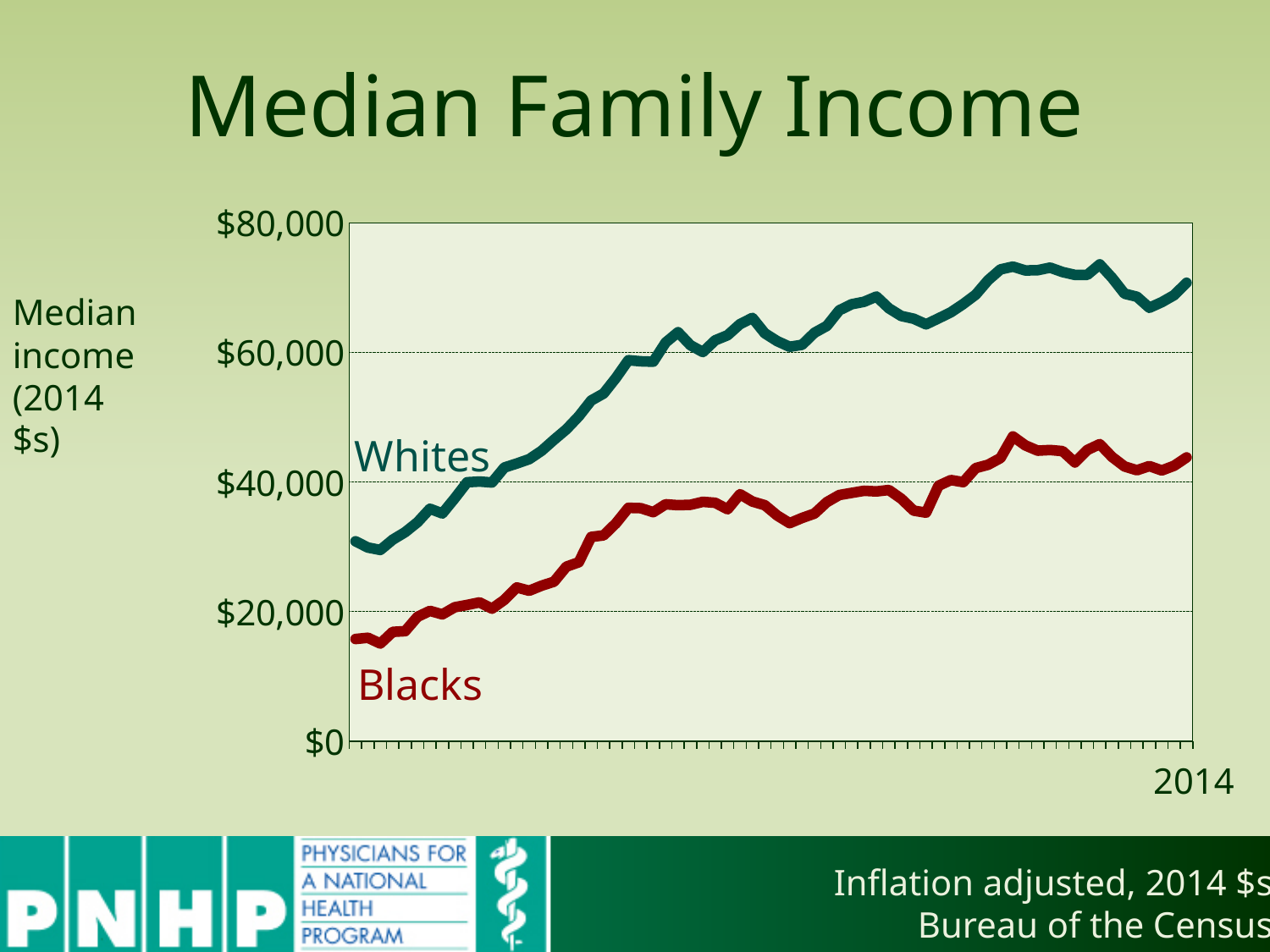
Is the median family income for Whites in 2014 greater or less than $60,000? greater Is the median family income for Whites at the start of the series greater or less than $20,000? greater Does the median family income for Blacks ever exceed $60,000 on the chart? No Over the whole period shown, does the median family income for Whites generally rise or fall? rise How many series are plotted on the chart? 2 What kind of chart is shown on the slide? line chart What is the title of the chart? Median Family Income Which series has the higher median family income throughout the chart, Whites or Blacks? Whites What is the last year labeled on the x axis? 2014